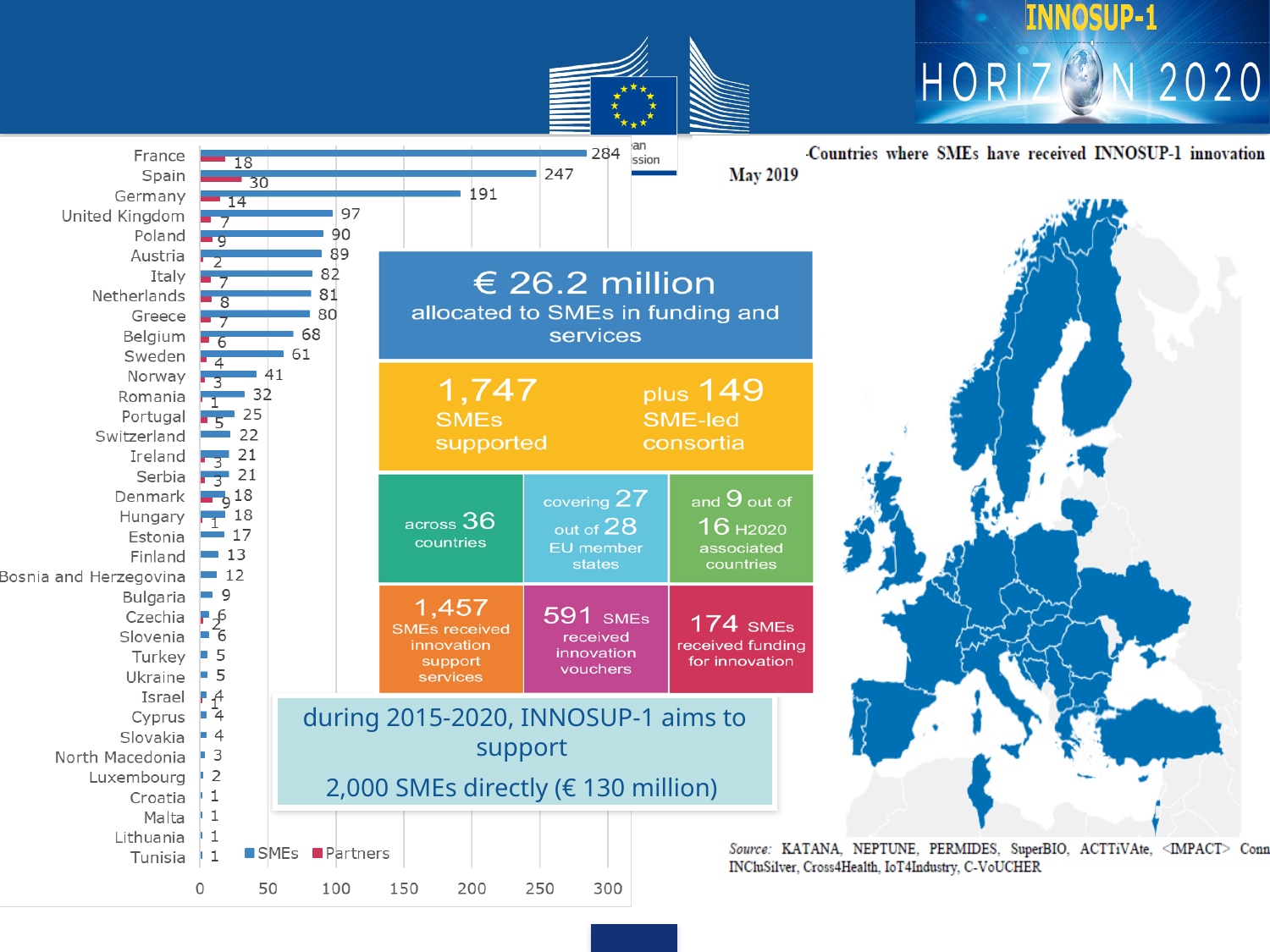
What kind of chart is shown on the left of the slide? Bar chart How many series does the legend of the bar chart list? 2 What is the difference between the SMEs values for France and Spain? 37 Which country has the highest Partners value in the bar chart? Spain Which has a larger SMEs value, Norway or Romania? Norway Is the SMEs value for Germany greater or less than 150? greater How many SMEs does the bar chart show for France? 284 What is the SMEs value for Germany in the bar chart? 191 What is the SMEs value for Belgium in the bar chart? 68 How many countries are listed in the bar chart? 36 Which country has the highest SMEs value in the bar chart? France What is the Partners value for Spain in the bar chart? 30